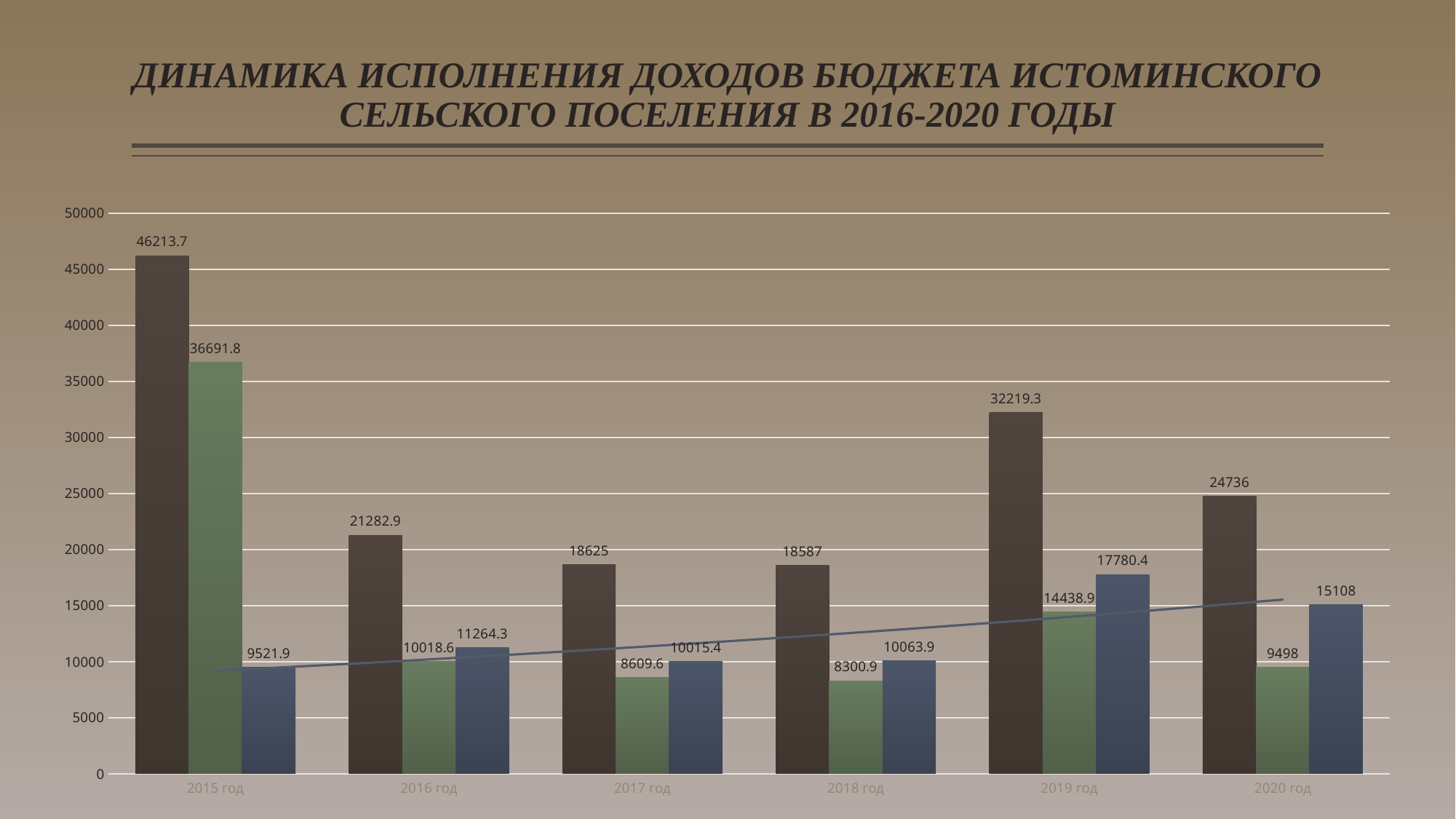
How many years are shown on the x axis? 6 What kind of chart is shown on the slide? bar chart What is the difference between the blue bar for 2019 год and the blue bar for 2018 год? 7716.5 What is the value of the green bar for 2019 год? 14438.9 In which year is the dark brown bar the highest? 2015 год Does the trend line drawn across the chart rise or fall from 2015 год to 2020 год? rise What is the difference between the dark brown bar and the green bar for 2015 год? 9521.9 Which is larger for 2016 год, the green bar or the blue bar? the blue bar What is the value of the dark brown bar for 2015 год? 46213.7 Is the value of the dark brown bar for 2019 год greater or less than 30000? greater What is the value of the blue bar for 2020 год? 15108 In which year is the green bar the lowest? 2018 год